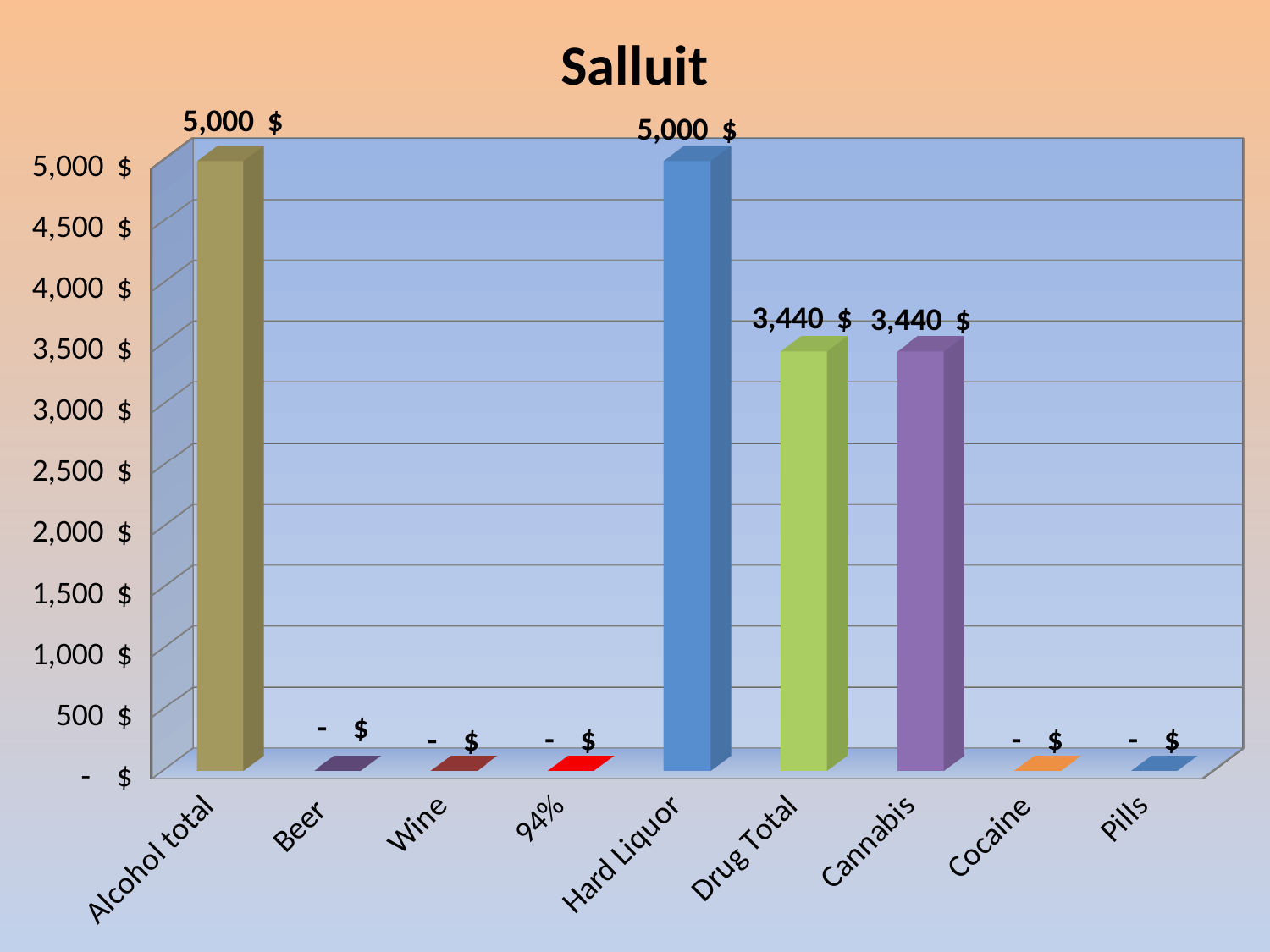
What is the value for Hard Liquor? 5,000 $ Is the value for Drug Total greater or less than 3,000 $? greater What kind of chart is this? bar chart Which is larger, the value for Hard Liquor or the value for Drug Total? Hard Liquor What is the title of the chart? Salluit What is the value for Cannabis? 3,440 $ What is the value shown for Beer? - $ What is the difference between the value for Alcohol total and the value for Cannabis? 1,560 $ How many categories are shown on the x axis? 9 What is the value for Drug Total? 3,440 $ What is the value for Alcohol total? 5,000 $ What is the value shown for Cocaine? - $